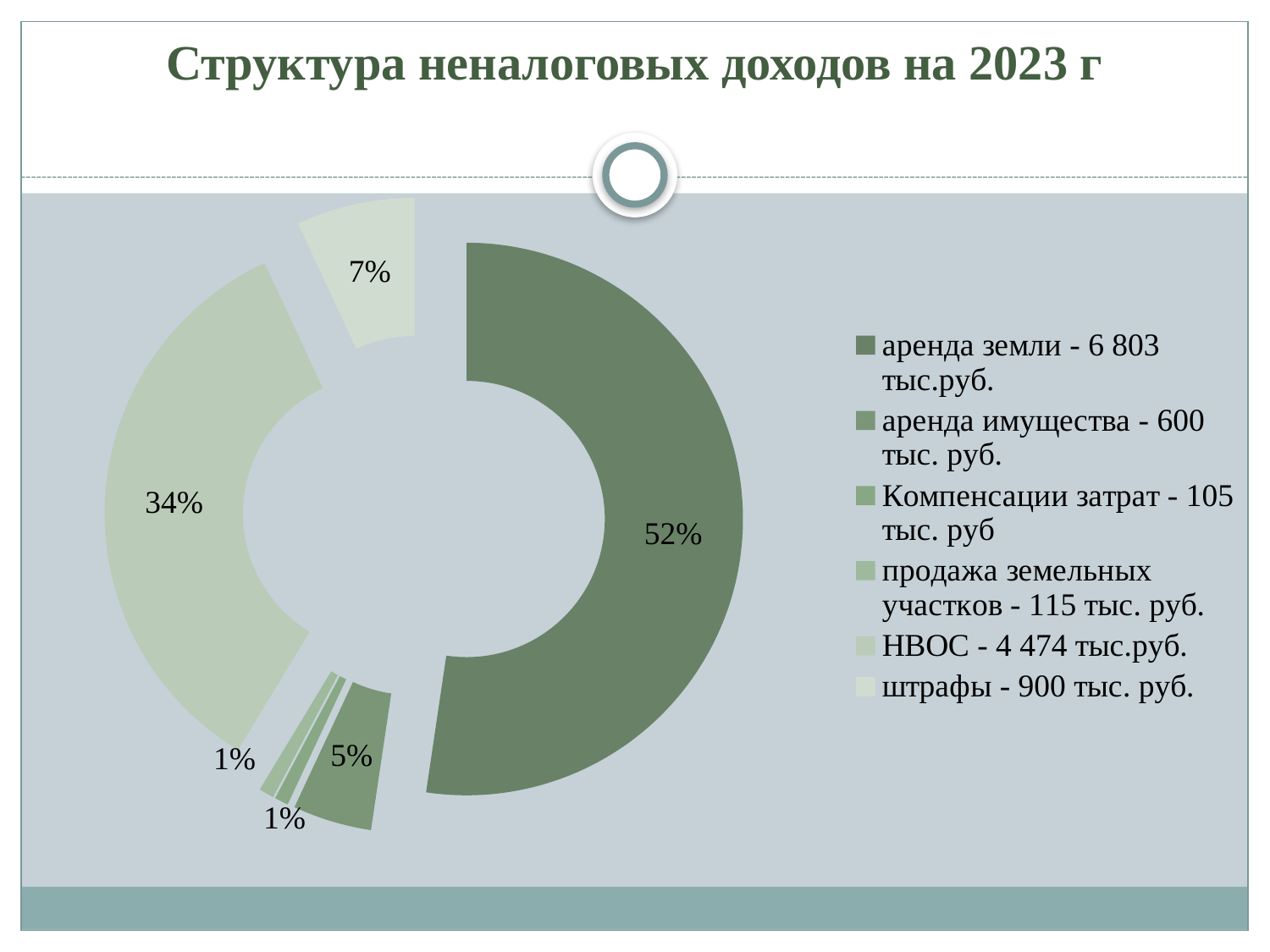
Which has the larger share: "НВОС" or "штрафы"? НВОС What is the title of the chart on the slide? Структура неналоговых доходов на 2023 г What share of the doughnut chart does "аренда имущества" take? 5% What kind of chart is shown on the slide? doughnut chart What share of the doughnut chart does "Компенсации затрат" take? 1% How many categories does the doughnut chart show? 6 What share of the doughnut chart does "аренда земли" take? 52% Which category has the largest share of the doughnut chart? аренда земли According to the legend, what amount is given for "НВОС"? 4 474 тыс.руб. What is the difference in percentage points between the shares of "аренда земли" and "НВОС"? 18